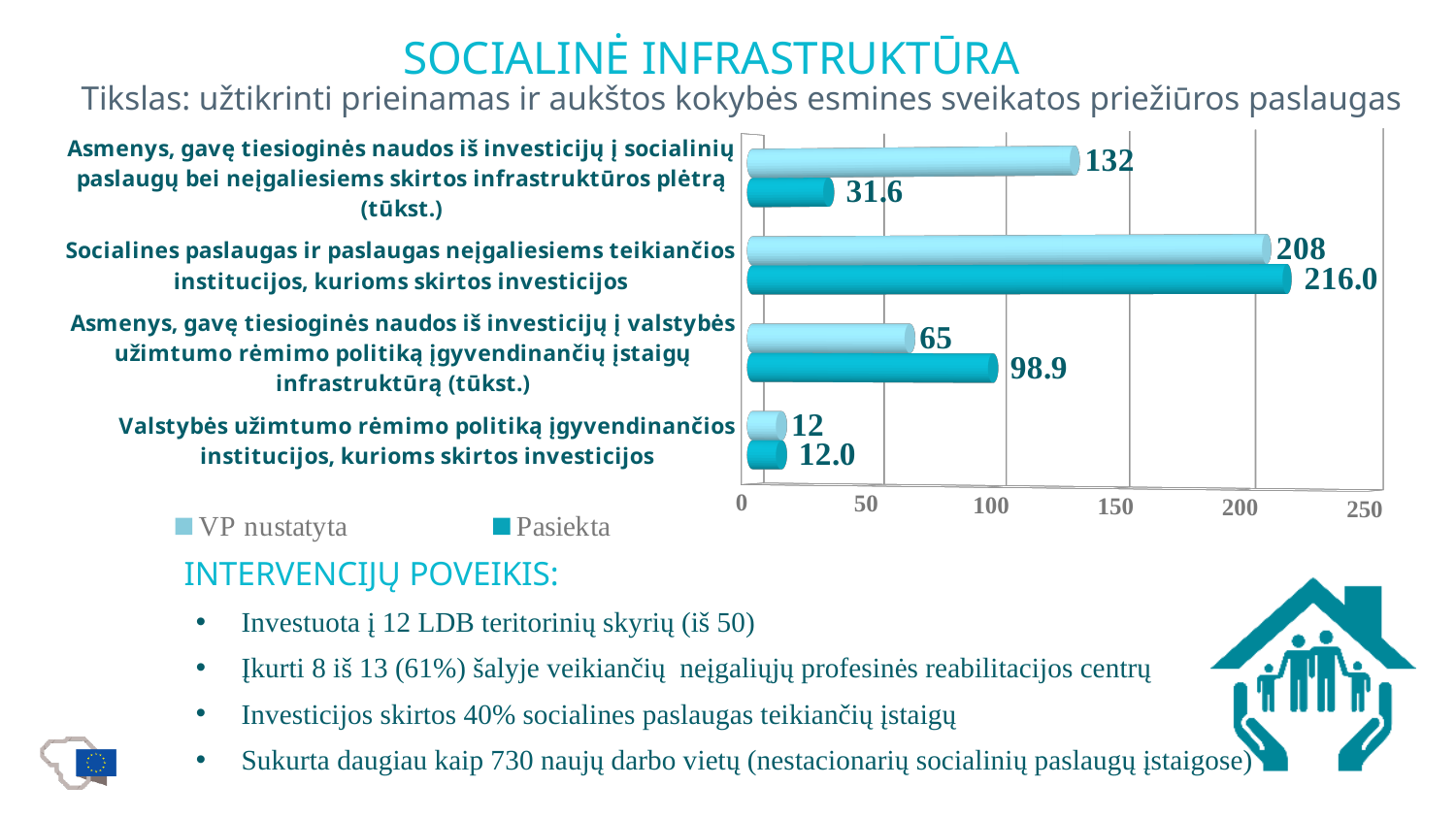
Which category has the highest 'Pasiekta' value? Socialines paslaugas ir paslaugas neįgaliesiems teikiančios institucijos, kurioms skirtos investicijos What is the difference between the 'Pasiekta' and 'VP nustatyta' values for 'Asmenys, gavę tiesioginės naudos iš investicijų į valstybės užimtumo rėmimo politiką įgyvendinančių įstaigų infrastruktūrą (tūkst.)'? 33.9 What type of chart is shown on the slide? bar chart For 'Socialines paslaugas ir paslaugas neįgaliesiems teikiančios institucijos, kurioms skirtos investicijos', which is larger: the 'VP nustatyta' value or the 'Pasiekta' value? Pasiekta How many categories are plotted on the chart? 4 What is the 'VP nustatyta' value for 'Asmenys, gavę tiesioginės naudos iš investicijų į socialinių paslaugų bei neįgaliesiems skirtos infrastruktūros plėtrą (tūkst.)'? 132 What is the 'Pasiekta' value for 'Socialines paslaugas ir paslaugas neįgaliesiems teikiančios institucijos, kurioms skirtos investicijos'? 216.0 How many series does the chart legend list? 2 What is the 'Pasiekta' value for 'Asmenys, gavę tiesioginės naudos iš investicijų į socialinių paslaugų bei neįgaliesiems skirtos infrastruktūros plėtrą (tūkst.)'? 31.6 What is the 'VP nustatyta' value for 'Asmenys, gavę tiesioginės naudos iš investicijų į valstybės užimtumo rėmimo politiką įgyvendinančių įstaigų infrastruktūrą (tūkst.)'? 65 Which category has the lowest 'VP nustatyta' value? Valstybės užimtumo rėmimo politiką įgyvendinančios institucijos, kurioms skirtos investicijos What is the 'Pasiekta' value for 'Valstybės užimtumo rėmimo politiką įgyvendinančios institucijos, kurioms skirtos investicijos'? 12.0